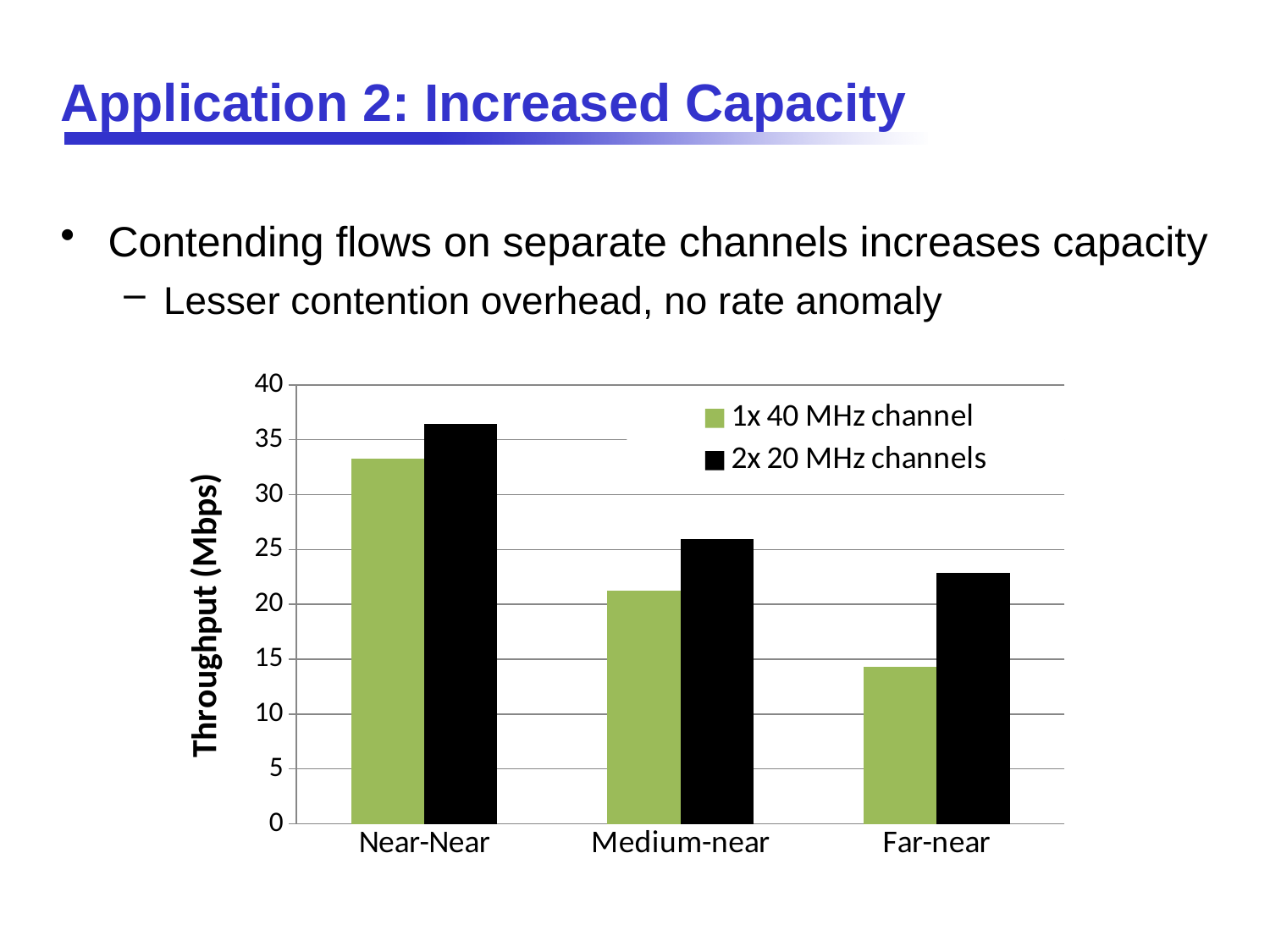
Is the 2x 20 MHz channels throughput for Medium-near greater or less than 25? greater Which category has the highest throughput for the 2x 20 MHz channels series? Near-Near What is the label of the y axis of the chart? Throughput (Mbps) Is the 1x 40 MHz channel throughput for Far-near greater or less than 15? less Which colour represents the 2x 20 MHz channels series in the chart? black Which category has the lowest throughput for the 1x 40 MHz channel series? Far-near What kind of chart is shown on the slide? bar chart Do the 1x 40 MHz channel throughput values rise or fall from Near-Near to Far-near? fall How many series does the chart legend list? 2 How many categories are shown on the x axis of the chart? 3 Is the 1x 40 MHz channel throughput for Near-Near greater or less than 30? greater For Far-near, which series has the larger throughput: 1x 40 MHz channel or 2x 20 MHz channels? 2x 20 MHz channels